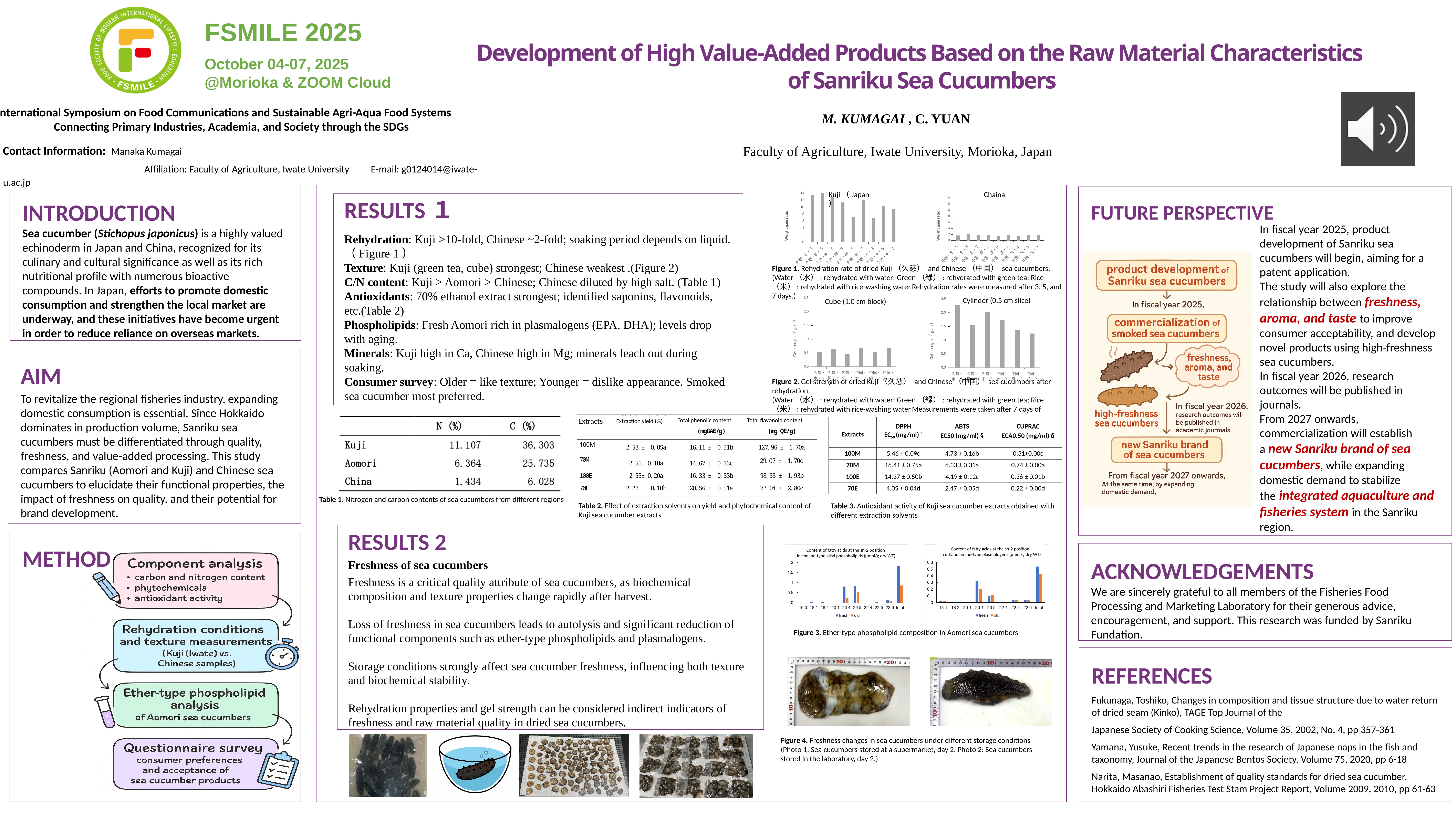
In Figure 1, which chart shows higher weight gain ratios, Kuji (Japan) or Chaina? Kuji (Japan) In Figure 3, how many series does the legend list? 2 In Figure 2, what is the y-axis label of the Cube (1.0 cm block) chart? Gel strength (g.cm) In the left chart of Figure 3 (choline-type alkyl phospholipids), which category has the highest fresh value? total In the left chart of Figure 3 (choline-type alkyl phospholipids), is the fresh value for total greater or less than 1.5? greater In the left chart of Figure 3 (choline-type alkyl phospholipids), how many fatty acid categories are shown on the x axis? 10 In the left chart of Figure 3 (choline-type alkyl phospholipids), which is larger for the total category, fresh or old? fresh In Figure 3, what are the two series named in the legend? fresh and old What kind of chart is used in Figure 1 for the Kuji (Japan) rehydration data? bar chart In the right chart of Figure 3 (ethanolamine-type plasmalogens), which category has the highest fresh value? total In the left chart of Figure 3 (choline-type alkyl phospholipids), is the old value for 20:4 greater or less than 0.5? less In the right chart of Figure 3 (ethanolamine-type plasmalogens), how many categories are shown on the x axis? 9